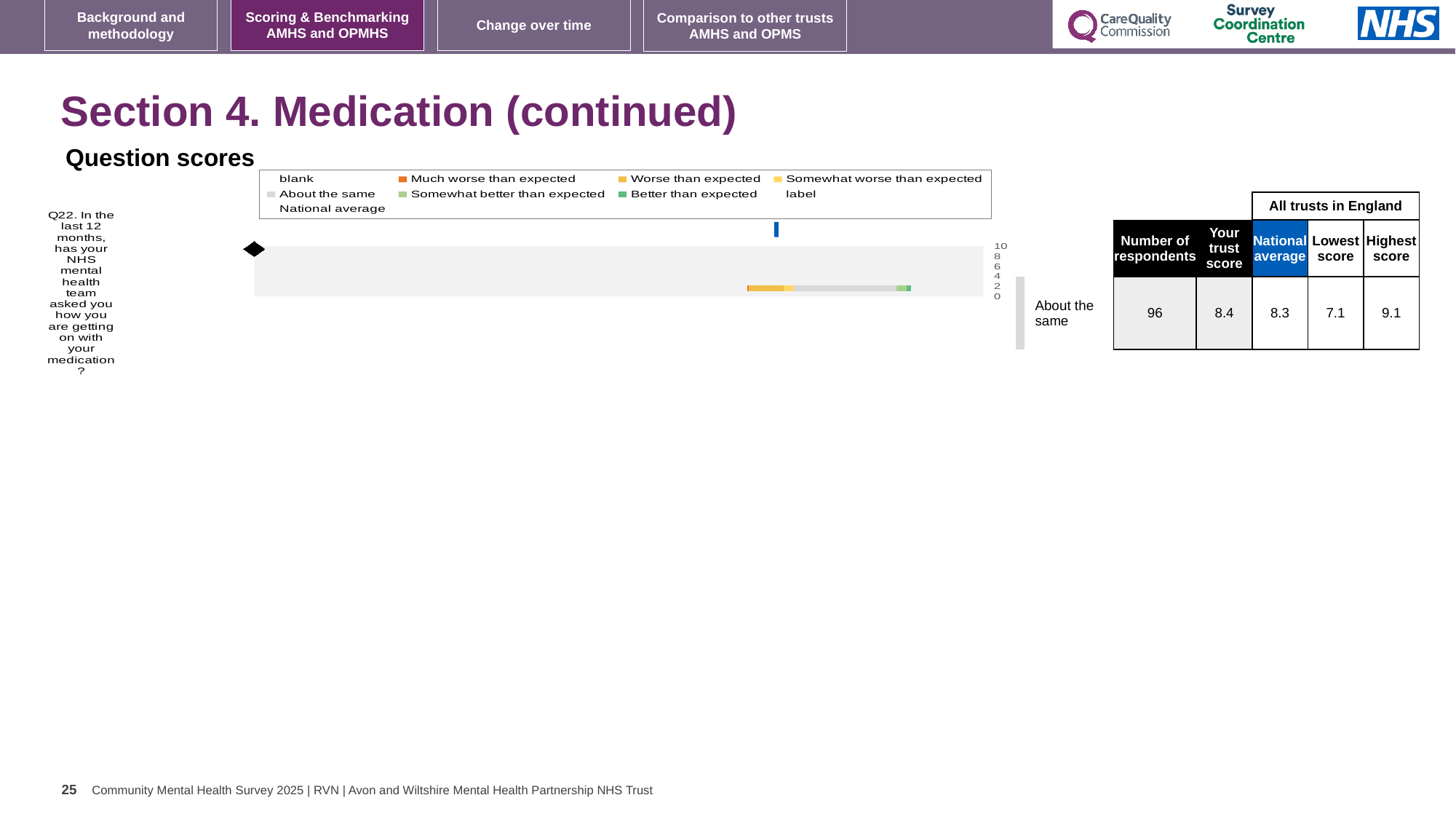
What benchmark rating is shown to the right of the chart for Q22? About the same Which is larger for Q22, the trust's score or the national average? the trust's score According to the table beside the chart, what is the trust's score for Q22? 8.4 Which survey question does the chart show? Q22. In the last 12 months, has your NHS mental health team asked you how you are getting on with your medication? According to the table beside the chart, what is the lowest score among all trusts in England for Q22? 7.1 How many survey questions are plotted in the chart? 1 According to the table beside the chart, what is the highest score among all trusts in England for Q22? 9.1 What is the difference between the highest score and the lowest score for Q22? 2.0 According to the table beside the chart, what is the national average for Q22? 8.3 According to the table beside the chart, how many respondents answered Q22? 96 What kind of chart is shown on the slide? bar chart